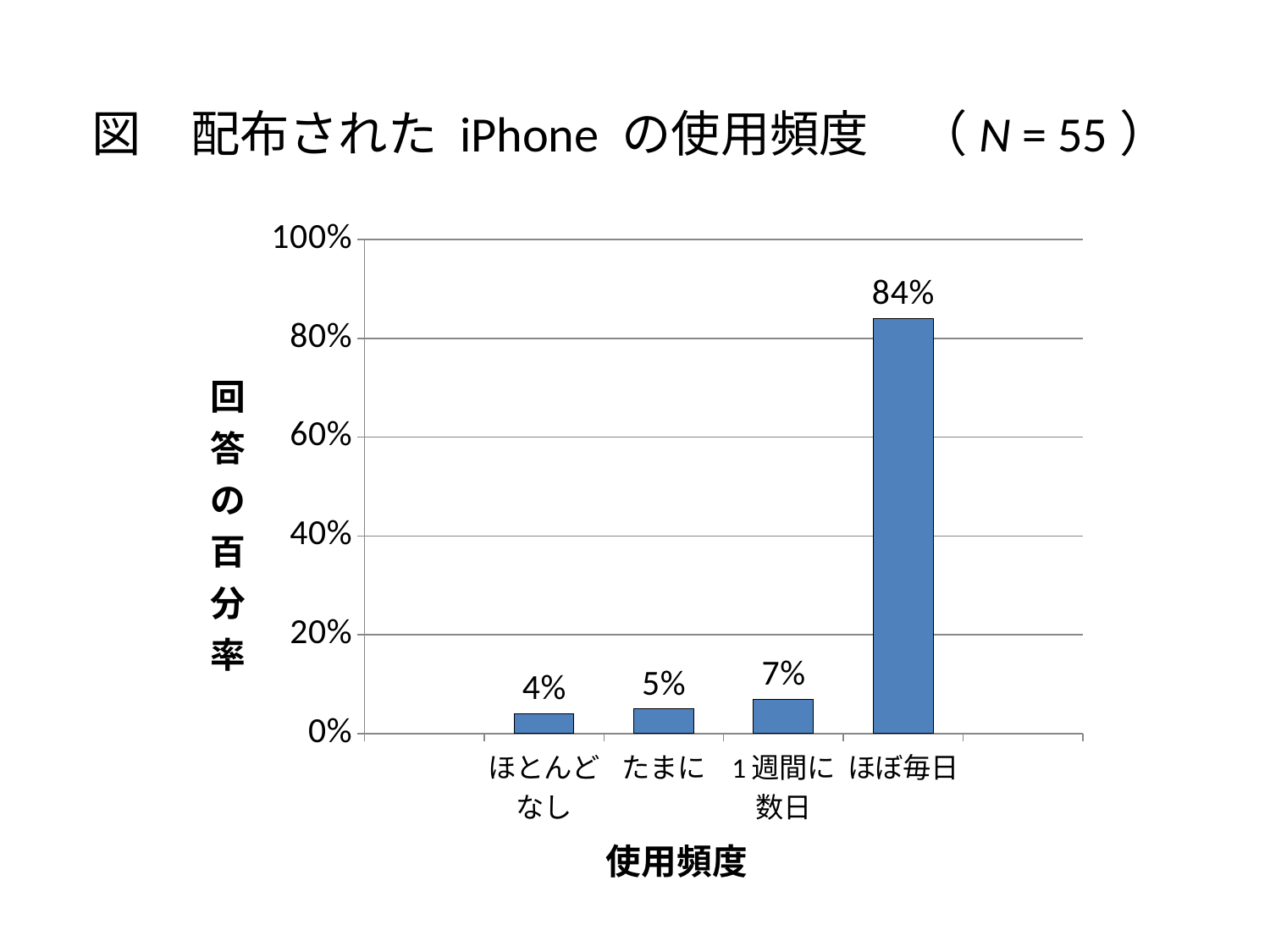
What is the value for 1週間に数日? 7% Which category has the highest value? ほぼ毎日 What is the value for たまに? 5% How many categories are shown on the x axis? 4 What is the difference between the values for ほぼ毎日 and 1週間に数日? 77% Which is larger, the value for たまに or the value for 1週間に数日? 1週間に数日 What is the label of the x axis? 使用頻度 Is the value for ほぼ毎日 greater or less than 80%? greater Which category has the lowest value? ほとんどなし What kind of chart is this? bar chart What is the value for ほぼ毎日? 84% What is the value for ほとんどなし? 4%